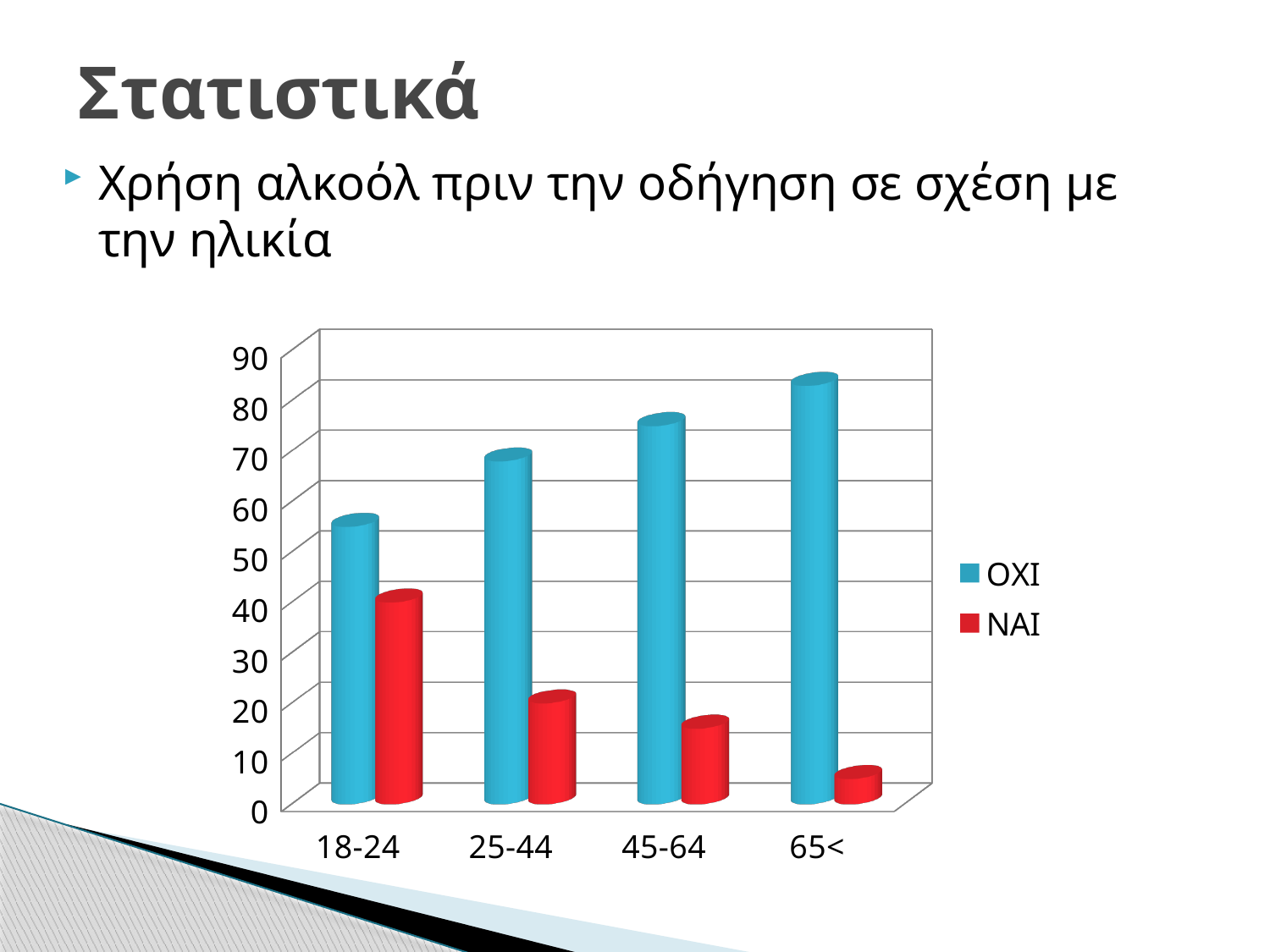
How many age groups are shown on the x axis of the chart? 4 Which age group has the highest value for ΝΑΙ? 18-24 Do the ΟΧΙ values rise or fall as the age groups go from 18-24 to 65<? rise Which age group has the highest value for ΟΧΙ? 65< Which colour represents the ΝΑΙ series in the chart? red What kind of chart is shown on the slide? bar chart How many series does the chart's legend list? 2 Is the value for ΝΑΙ in the 65< group greater or less than 10? less Which age group has the lowest value for ΝΑΙ? 65< Is the value for ΝΑΙ in the 18-24 group greater or less than 30? greater Is the value for ΟΧΙ in the 18-24 group greater or less than 50? greater Which age group has the lowest value for ΟΧΙ? 18-24